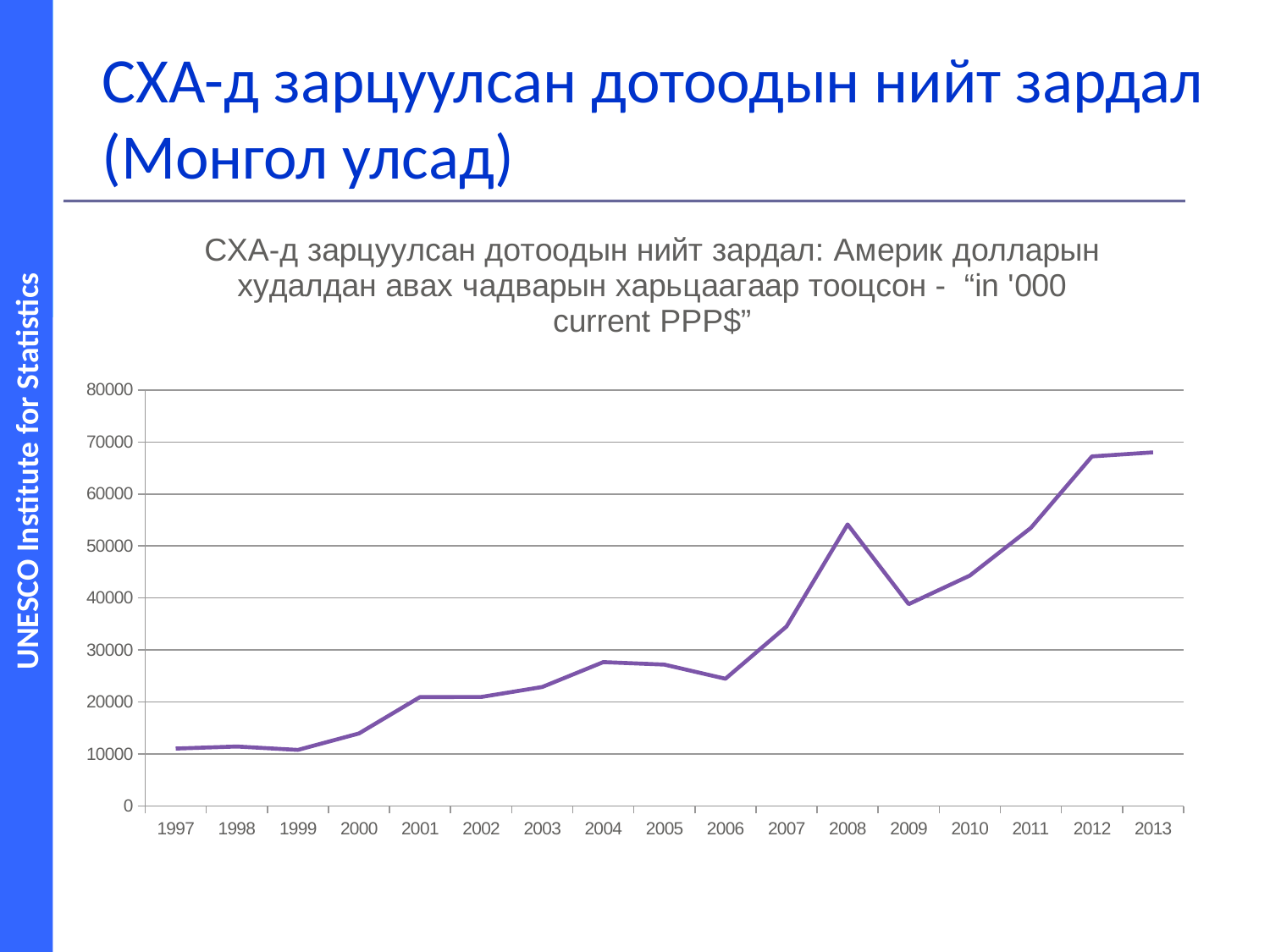
Is the value for 2008 greater or less than 50000? greater How many years are plotted along the x axis of the chart? 17 What kind of chart is shown on the slide? line chart Is the value for 2000 greater or less than 20000? less Is the value for 2007 greater or less than 30000? greater Which year has the larger value, 2004 or 2006? 2004 What is the first year shown on the x axis? 1997 What is the highest value labelled on the y axis? 80000 Which year has the larger value, 2008 or 2009? 2008 Overall, do the values rise or fall from 1997 to 2013? rise